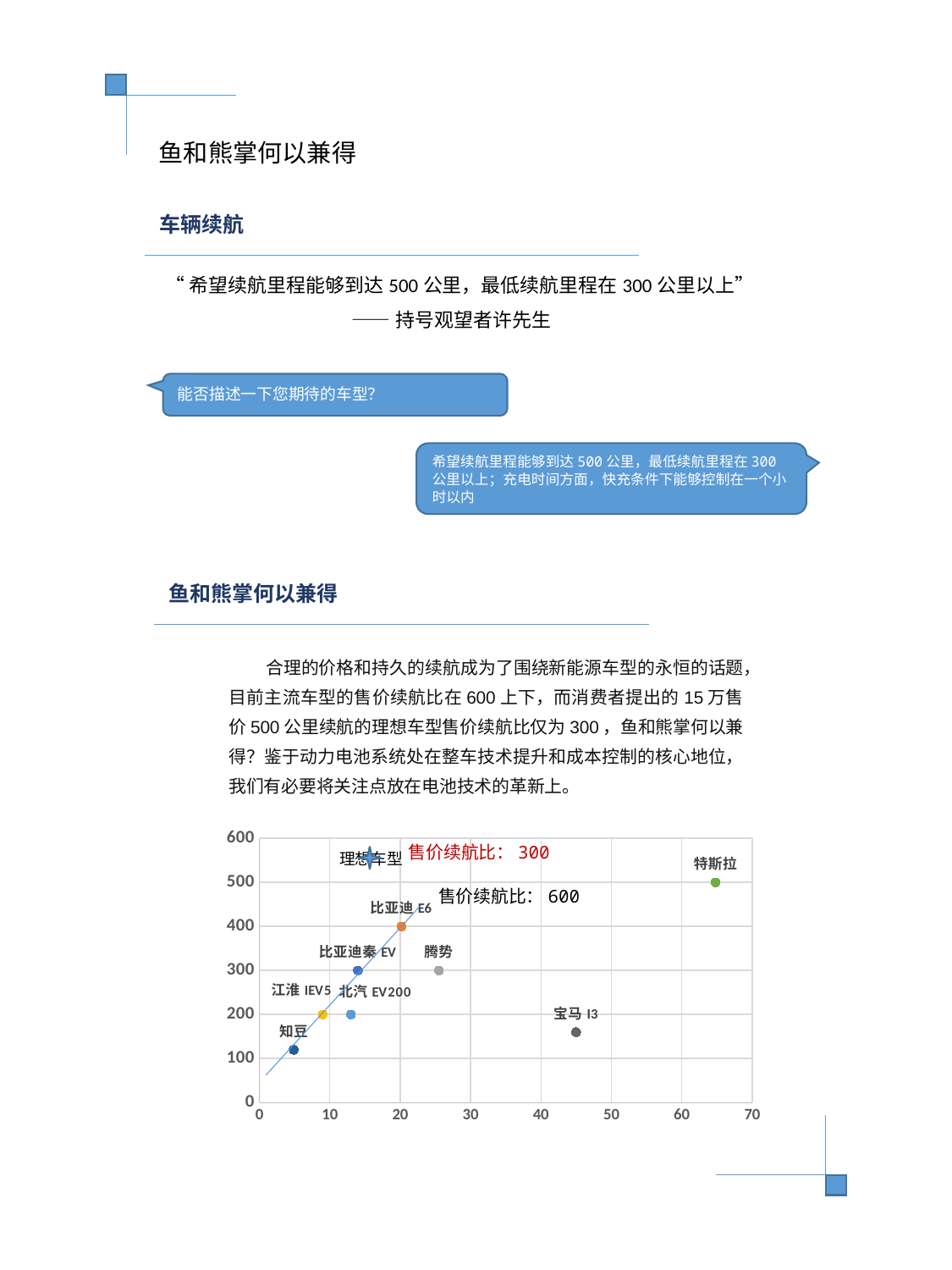
What kind of chart is shown on the slide? scatter chart Which car model has the lowest value on the vertical axis? 知豆 Is the horizontal-axis value for 特斯拉 greater or less than 60? greater Which car model is plotted furthest to the right on the horizontal axis? 特斯拉 Is the vertical-axis value for 宝马 I3 greater or less than 200? less What 售价续航比 value is written in red text on the chart? 300 Which has the higher vertical-axis value, 特斯拉 or 宝马 I3? 特斯拉 Which car model is plotted furthest to the left on the horizontal axis? 知豆 Is the horizontal-axis value for 腾势 greater or less than 20? greater